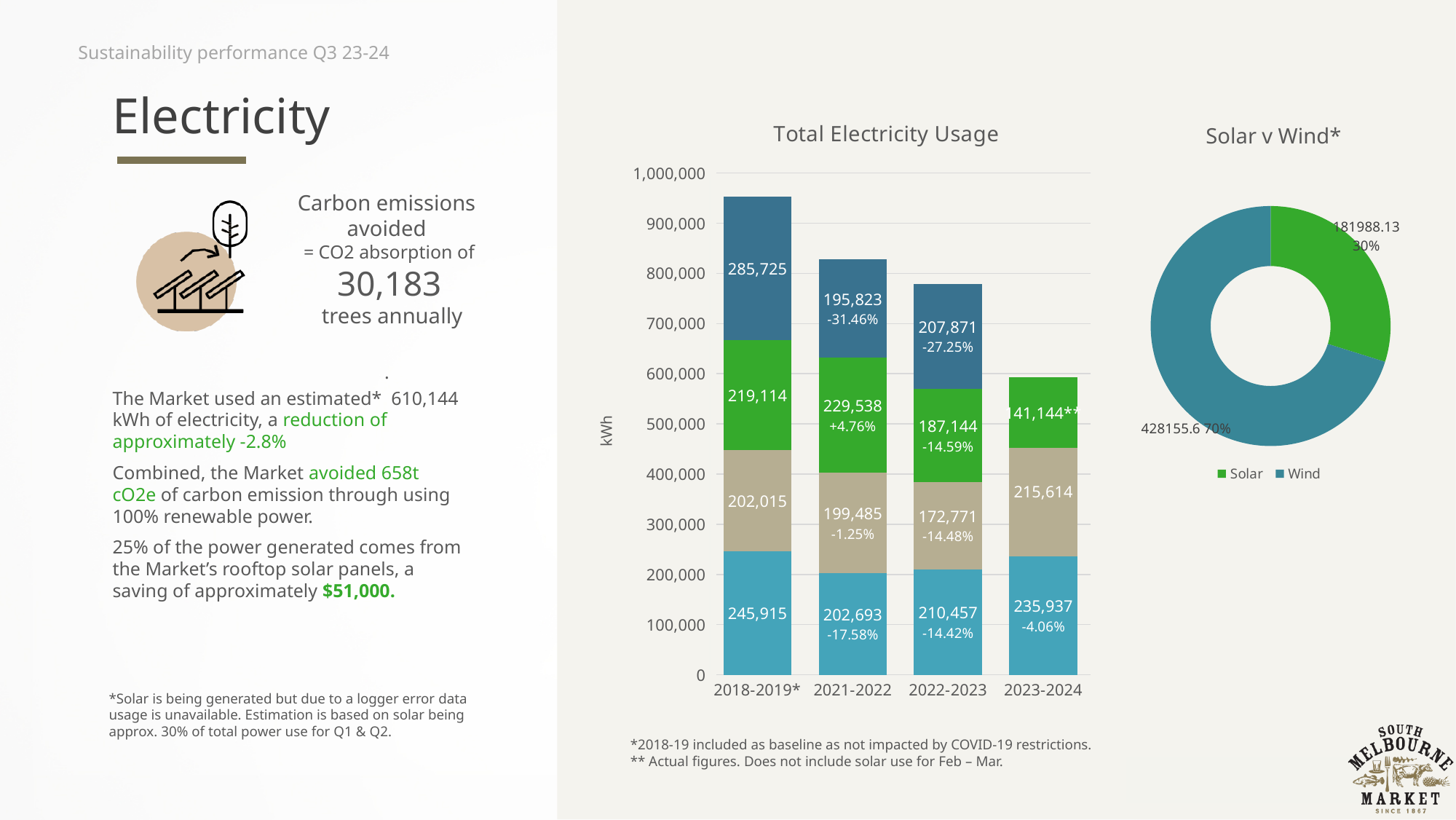
In the Total Electricity Usage chart, what is the value of the bottom (light blue) segment for 2018-2019*? 245,915 In the Total Electricity Usage chart, which year has the tallest stacked bar? 2018-2019* What kind of chart is the Total Electricity Usage chart? Bar chart In the Total Electricity Usage chart, what percentage change is shown for the bottom segment of 2021-2022? -17.58% In the Total Electricity Usage chart, what is the value of the top (dark blue) segment for 2021-2022? 195,823 In the Total Electricity Usage chart, what is the value of the tan segment for 2022-2023? 172,771 In the Solar v Wind* chart, what share of the doughnut does Wind represent? 70% How many series does the legend of the Solar v Wind* chart list? 2 How many year categories are shown on the x axis of the Total Electricity Usage chart? 4 In the Total Electricity Usage chart, what is the difference between the bottom segment values for 2018-2019* (245,915) and 2023-2024 (235,937)? 9,978 In the Total Electricity Usage chart, is the total for 2021-2022 greater or less than 800,000? greater In the Total Electricity Usage chart, what is the total of the stacked bar for 2018-2019*? 952,769